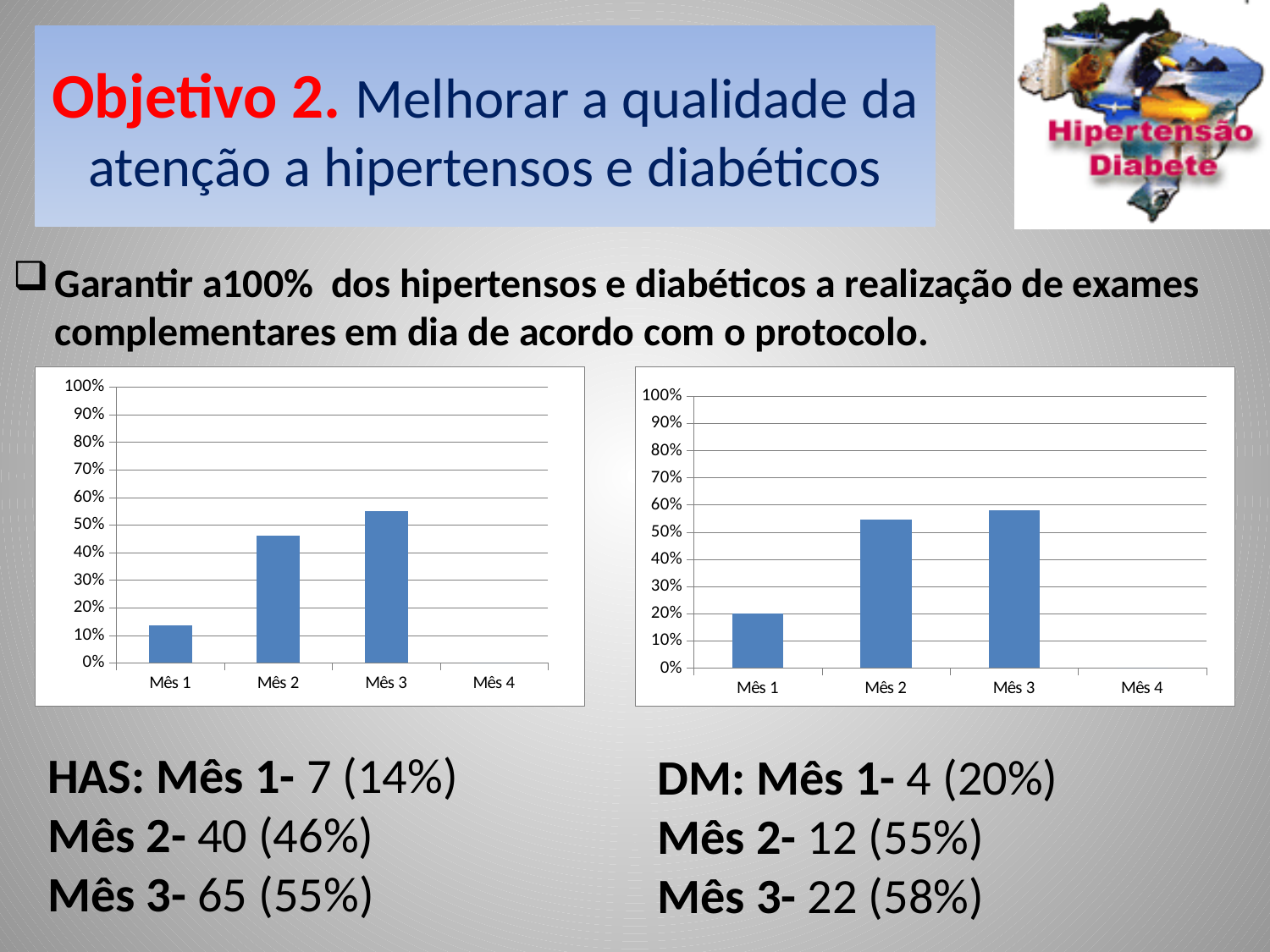
Using the HAS percentages printed on the slide, what is the difference between Mês 3 and Mês 1? 41 percentage points In the right chart, among Mês 1, Mês 2 and Mês 3, which month has the lowest value? Mês 1 What kind of chart is the left chart on the slide? bar chart According to the slide, what percentage is shown for DM in Mês 1 (right chart)? 20% In the left chart, is the value for Mês 1 greater or less than 20%? less In the left chart, which month has the tallest bar? Mês 3 In the left chart, which is larger, the value for Mês 2 or the value for Mês 3? Mês 3 What is the highest value shown on the y axis of the right chart? 100% In the right chart, is the value for Mês 3 greater or less than 50%? greater How many month categories are shown on the x axis of the right chart? 4 According to the slide, what percentage is shown for HAS in Mês 2 (left chart)? 46% Do the values in the left chart rise or fall from Mês 1 to Mês 3? rise